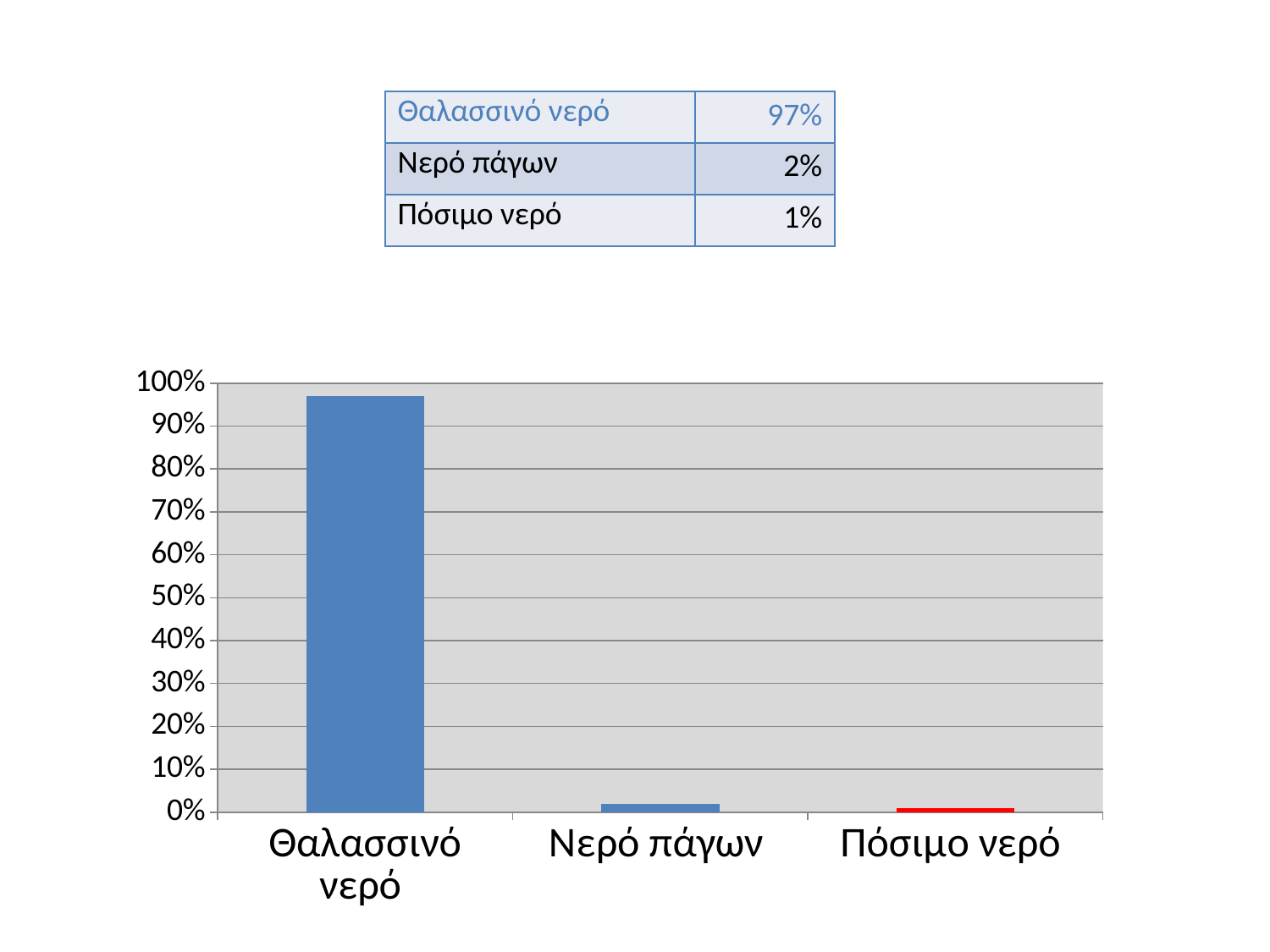
Is the value for Νερό πάγων greater or less than 10%? less Using the values in the table, what is the difference between Θαλασσινό νερό and Πόσιμο νερό? 96% What type of chart is shown on the slide? bar chart How many categories are shown on the x axis of the chart? 3 According to the table on the slide, what is the value for Θαλασσινό νερό? 97% Which category has the highest bar in the chart? Θαλασσινό νερό What colour is the bar for Πόσιμο νερό? red Which category has the lowest bar in the chart? Πόσιμο νερό Which is larger, the value for Θαλασσινό νερό or the value for Νερό πάγων? Θαλασσινό νερό Is the value for Θαλασσινό νερό greater or less than 90%? greater According to the table on the slide, what is the value for Νερό πάγων? 2% According to the table on the slide, what is the value for Πόσιμο νερό? 1%